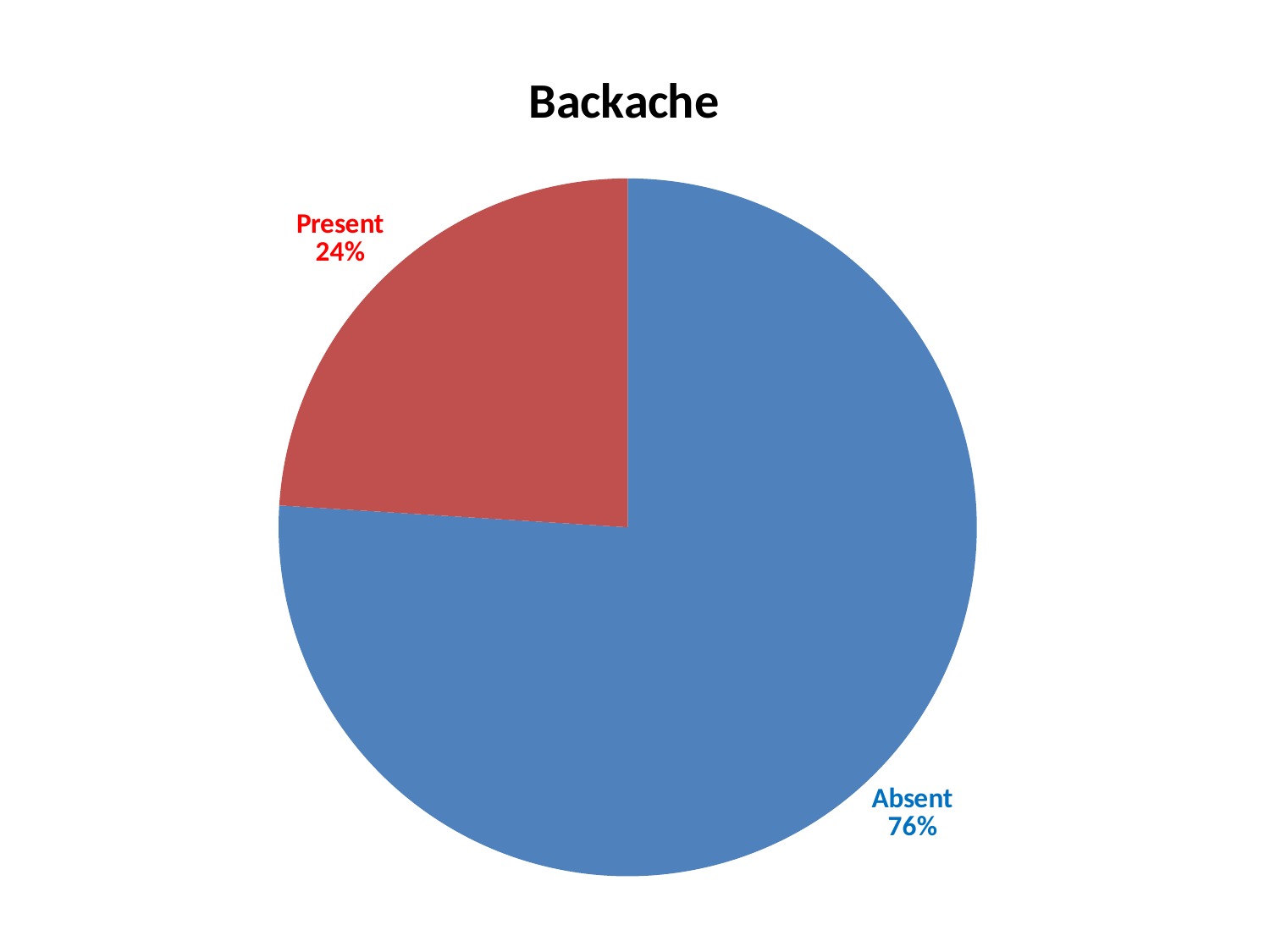
Which slice is the smallest? Present What is the difference in percentage points between the Absent and Present slices? 52 How many slices does the pie chart have? 2 What type of chart is shown on the slide? Pie chart What is the title of the chart? Backache What percentage of the pie is labelled Present? 24% What share of the pie does the Present slice represent? 24% Which slice is the largest? Absent What colour is the Absent slice? Blue What percentage of the pie is labelled Absent? 76% Is the share for Present greater or less than 50%? less Which is larger, the Present slice or the Absent slice? Absent